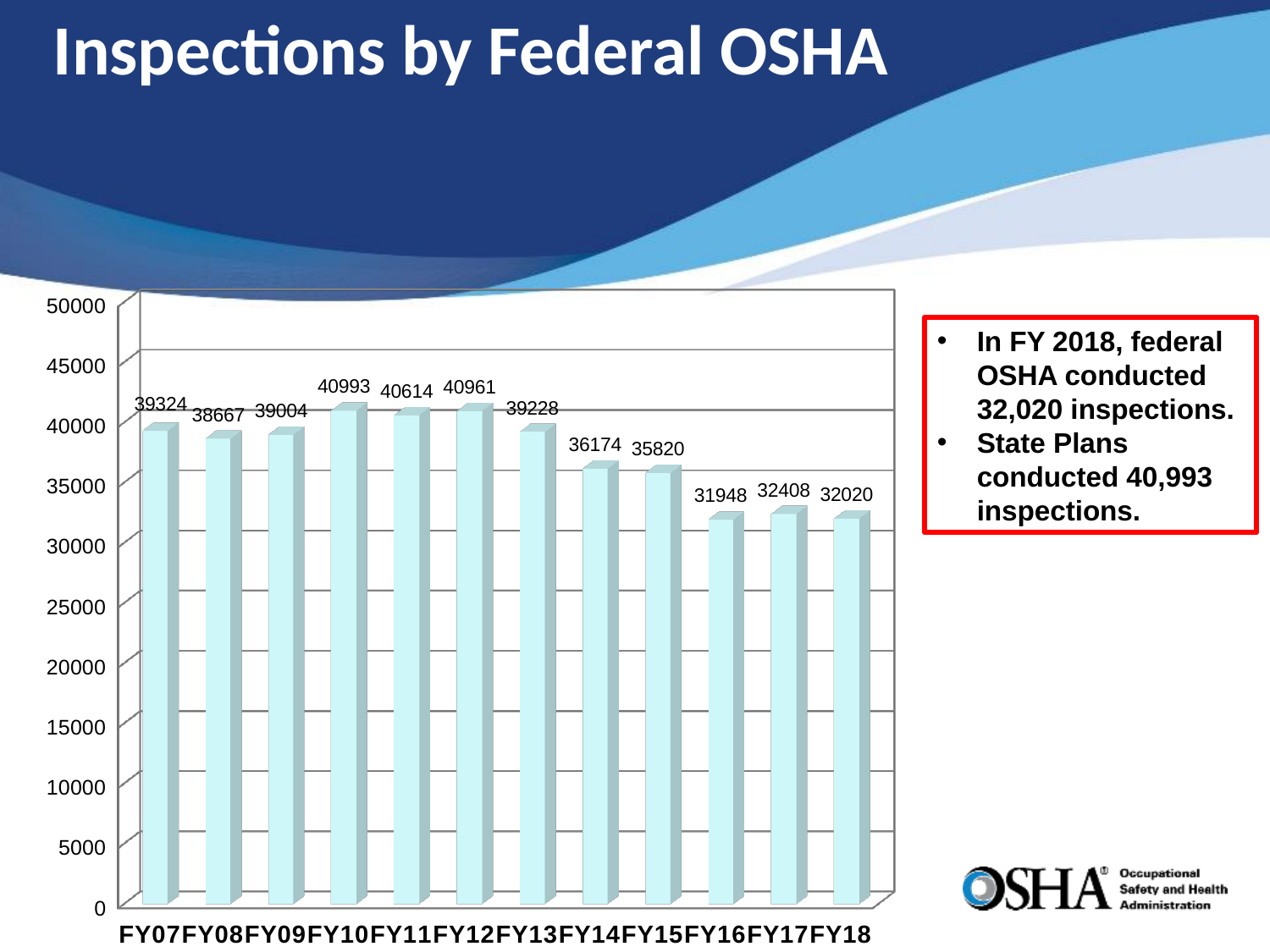
Which fiscal year has the lowest number of inspections? FY16 What is the number of inspections shown for FY14? 36174 Which has more inspections, FY13 or FY15? FY13 What type of chart is shown on the slide? bar chart What is the number of inspections shown for FY10? 40993 Which fiscal year has the highest number of inspections? FY10 Is the value for FY15 greater or less than 40000? less Do the inspection counts generally rise or fall from FY12 to FY16? fall What is the difference between the inspections in FY17 and FY16? 460 What is the number of inspections shown for FY18? 32020 What is the difference between the inspections in FY10 and FY18? 8973 How many fiscal years are plotted in the chart? 12